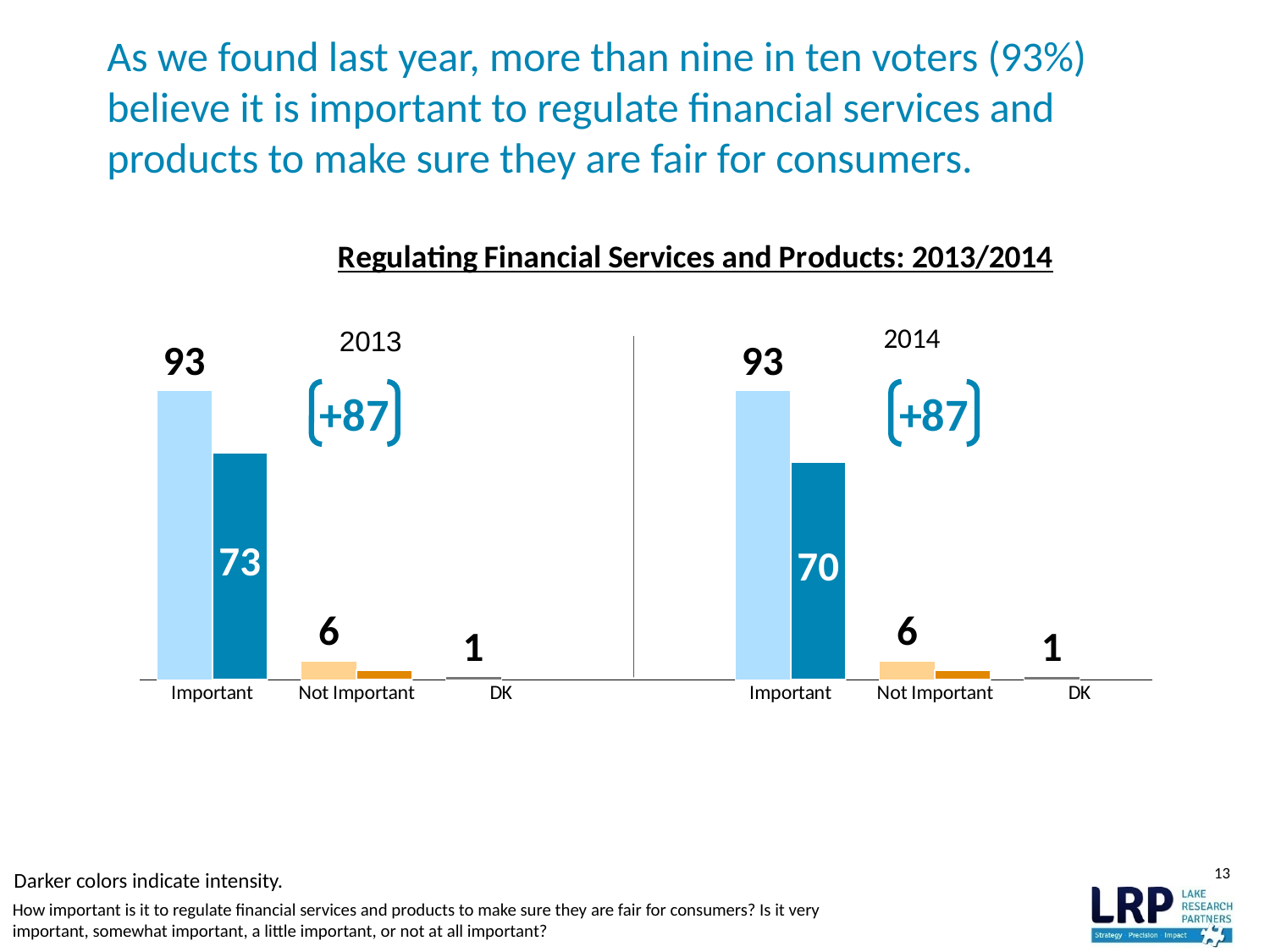
In the 2013 chart, which category has the highest value? Important What is the title shown above the two charts? Regulating Financial Services and Products: 2013/2014 In the 2013 chart, what is the value shown on the darker Important bar? 73 In the 2013 chart, what is the difference between the Important value and the Not Important value? 87 What kind of chart is used for the 2013 data? Bar chart In the 2014 chart, what is the value shown on the darker Important bar? 70 In the 2014 chart, which category has the lowest value? DK In the 2014 chart, what is the value for DK? 1 Which is larger: the darker Important bar in the 2013 chart or the darker Important bar in the 2014 chart? 2013 (73) In the 2013 chart, what is the value for Important? 93 How many categories are shown on the x axis of the 2014 chart? 3 In the 2014 chart, what is the value for Not Important? 6